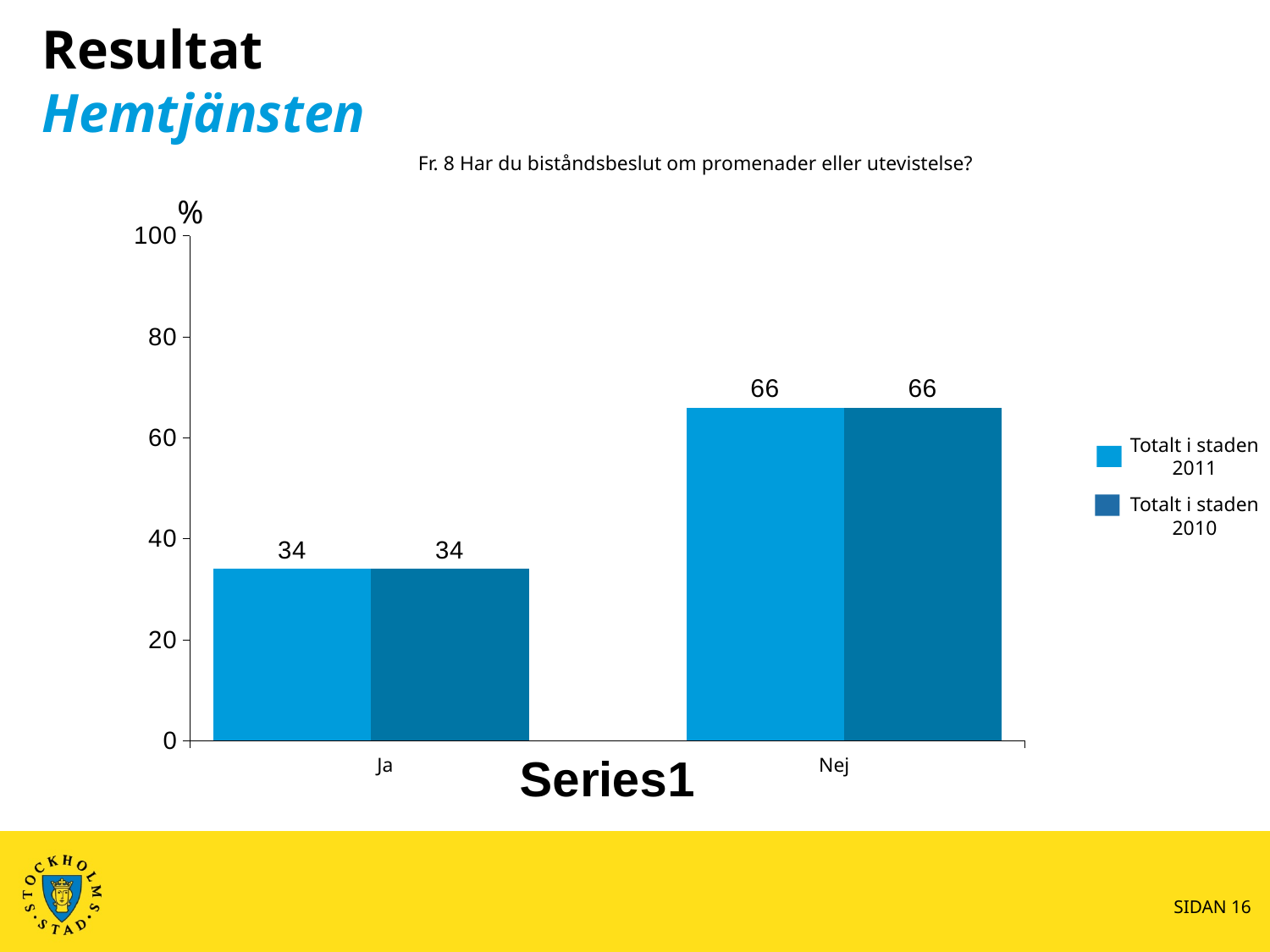
What is the value for "Nej" in the "Totalt i staden 2010" series? 66 What is the value for "Ja" in the "Totalt i staden 2011" series? 34 How many series does the legend list? 2 What is the value for "Nej" in the "Totalt i staden 2011" series? 66 What kind of chart is shown on the slide? bar chart How many categories are shown on the x axis? 2 Which category has the lowest value in the "Totalt i staden 2010" series? Ja What is the difference between the "Nej" and "Ja" values in the "Totalt i staden 2011" series? 32 Which category has the highest value in the "Totalt i staden 2011" series? Nej Is the value for "Nej" in the "Totalt i staden 2011" series greater or less than 60? greater What question is the chart about, as stated above the chart? Fr. 8 Har du biståndsbeslut om promenader eller utevistelse? Which is larger in the "Totalt i staden 2010" series: "Ja" or "Nej"? Nej